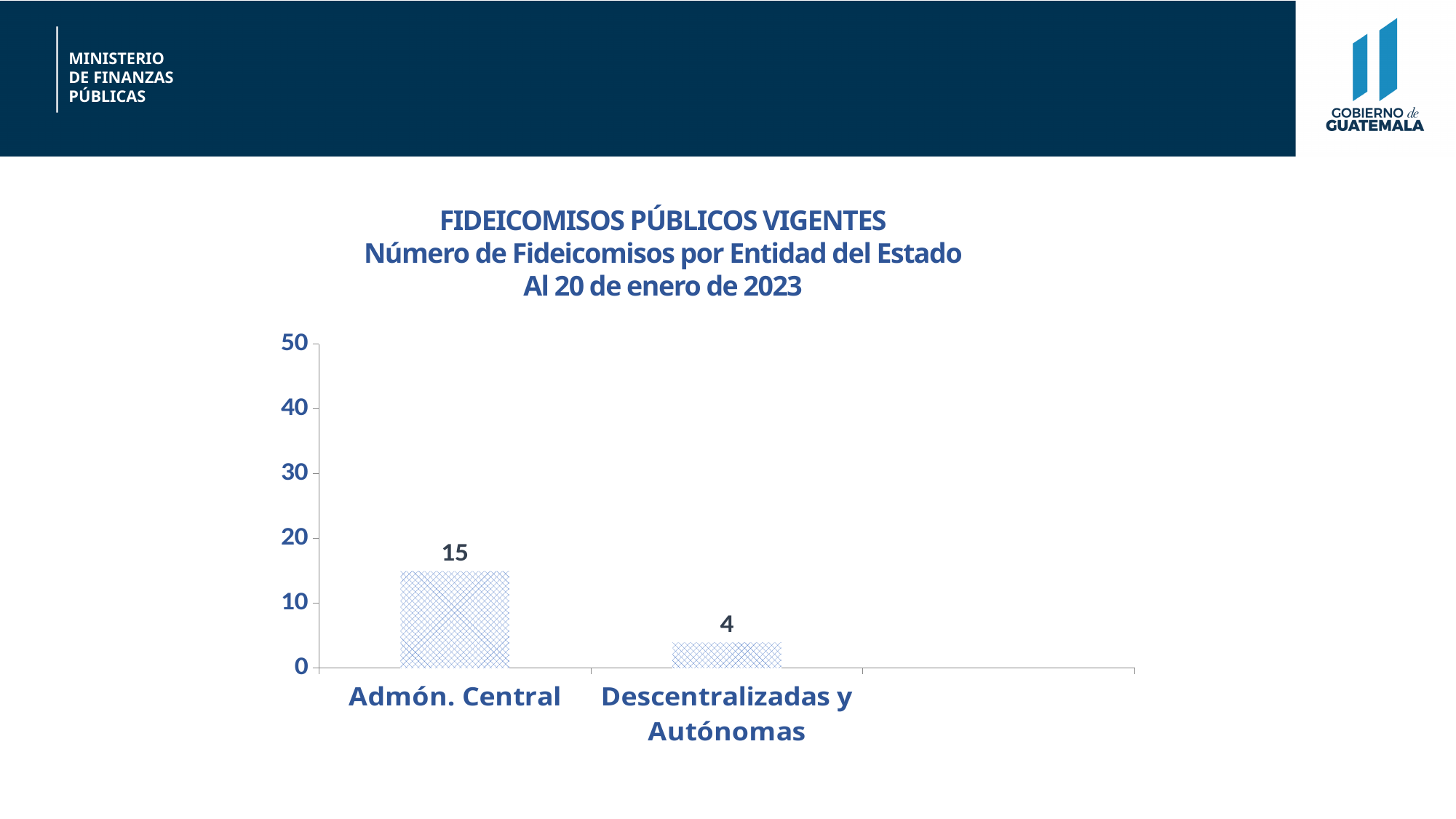
What is the total of the two values shown in the chart? 19 Which category has the highest value? Admón. Central What kind of chart is shown on the slide? bar chart Which is larger, the value for Admón. Central or the value for Descentralizadas y Autónomas? Admón. Central How many categories are shown on the x axis? 2 What is the highest value shown on the y axis? 50 Is the value for Descentralizadas y Autónomas greater or less than 10? less What is the difference between the values for Admón. Central and Descentralizadas y Autónomas? 11 Is the value for Admón. Central greater or less than 20? less Which category has the lowest value? Descentralizadas y Autónomas What is the value for Descentralizadas y Autónomas? 4 What is the value for Admón. Central? 15